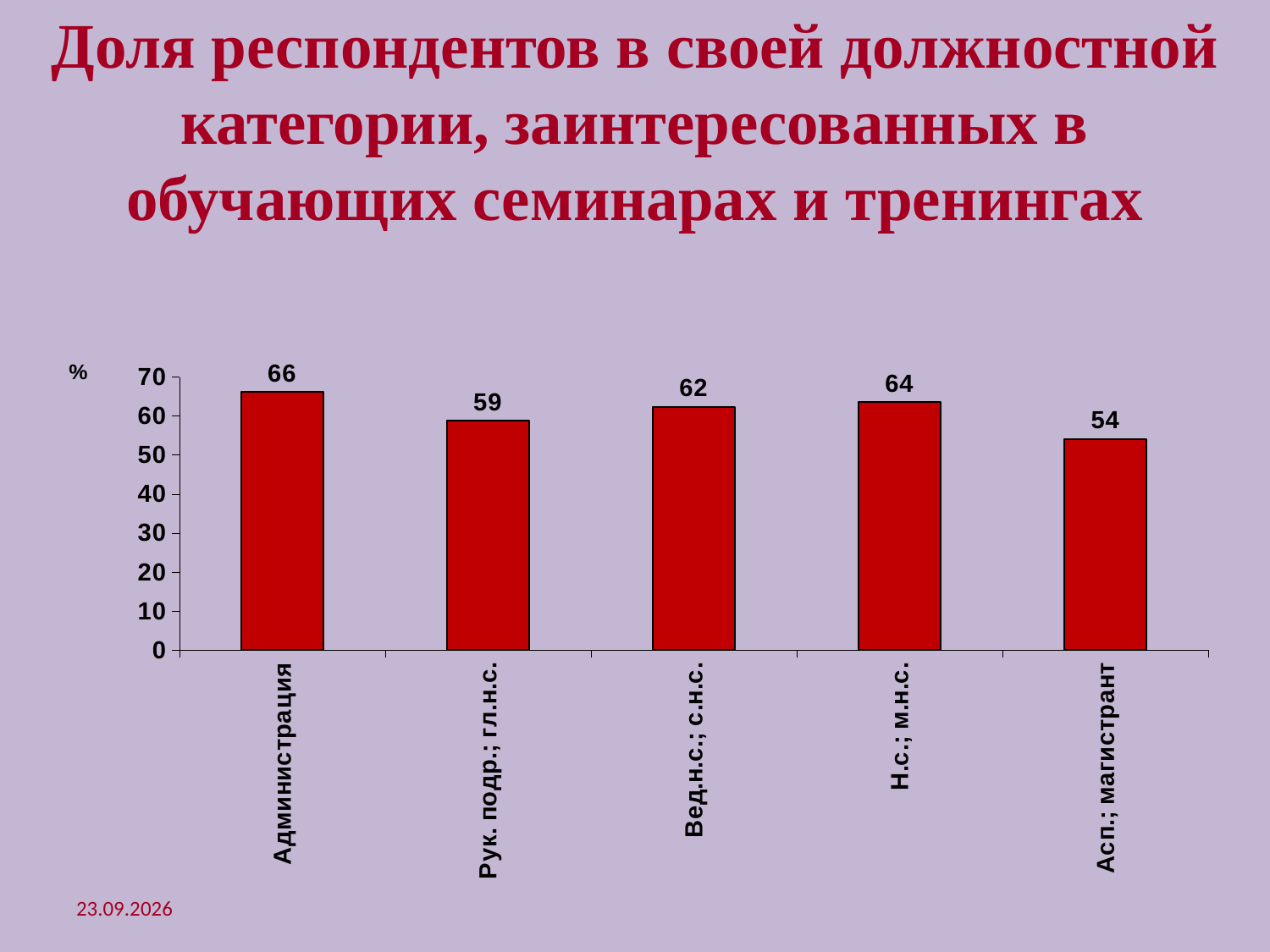
What kind of chart is shown on the slide? bar chart What colour are the bars in the chart? red Is the value for Рук. подр.; гл.н.с. greater or less than 50? greater Which is larger, the value for Рук. подр.; гл.н.с. or the value for Вед.н.с.; с.н.с.? Вед.н.с.; с.н.с. Which category has the lowest value? Асп.; магистрант Which category has the highest value? Администрация What is the difference between the values for Администрация and Асп.; магистрант? 12 What unit is indicated on the vertical axis of the chart? % What is the value for Н.с.; м.н.с.? 64 What is the value for Асп.; магистрант? 54 How many categories are shown on the chart? 5 What is the value for Администрация? 66